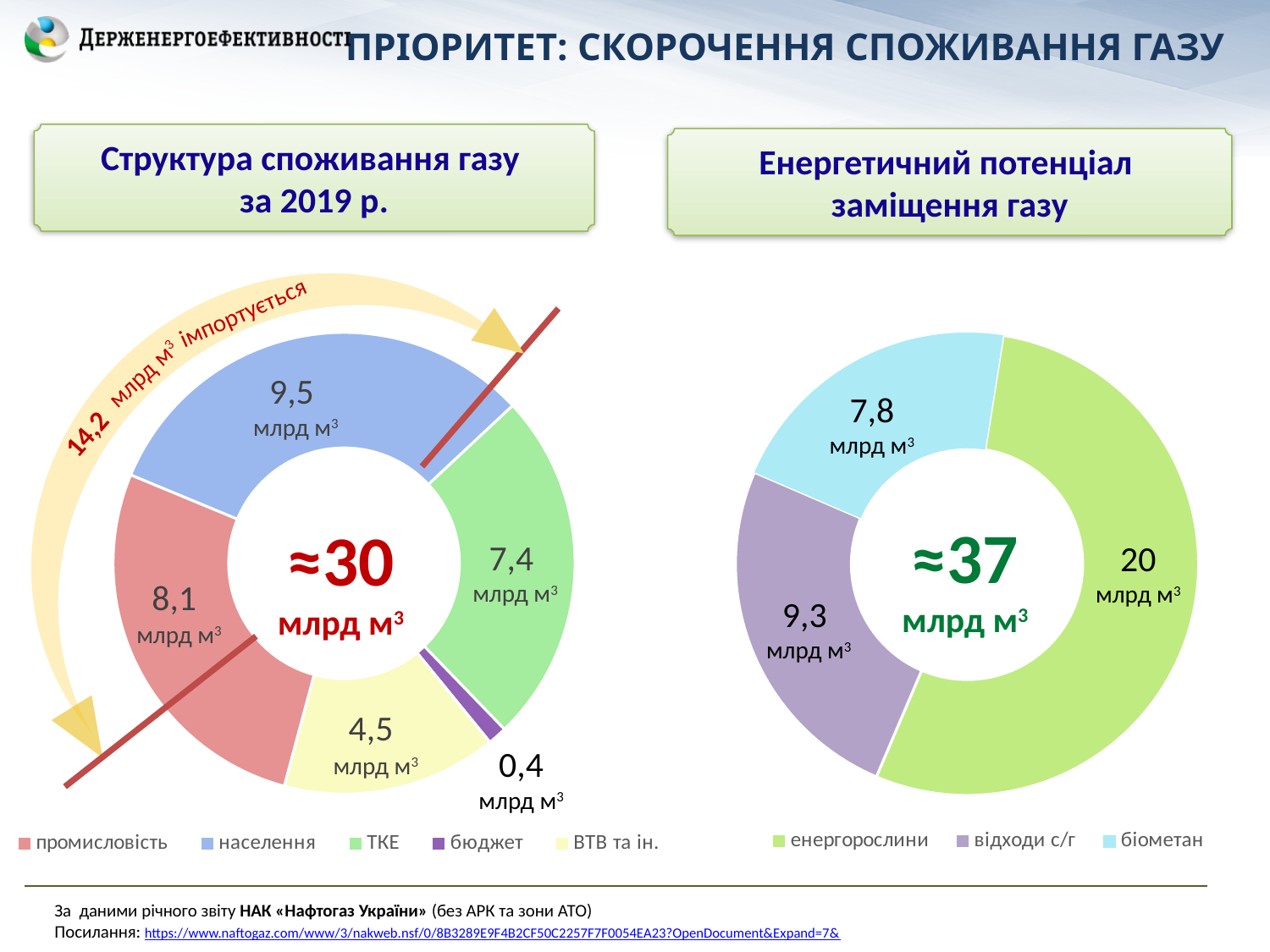
In the chart 'Енергетичний потенціал заміщення газу', which category has the highest value? енергорослини In the chart 'Енергетичний потенціал заміщення газу', which is larger: відходи с/г or біометан? відходи с/г In the chart 'Структура споживання газу за 2019 р.', which category has the highest value? населення In the chart 'Структура споживання газу за 2019 р.', what is the value for ТКЕ? 7,4 млрд м3 In the chart 'Структура споживання газу за 2019 р.', what is the value for населення? 9,5 млрд м3 In the chart 'Структура споживання газу за 2019 р.', which category has the lowest value? бюджет In the chart 'Структура споживання газу за 2019 р.', how many categories does the legend list? 5 In the chart 'Енергетичний потенціал заміщення газу', what is the difference between енергорослини and біометан? 12,2 млрд м3 In the chart 'Енергетичний потенціал заміщення газу', what is the value for відходи с/г? 9,3 млрд м3 What type of chart is 'Енергетичний потенціал заміщення газу'? doughnut chart In the chart 'Структура споживання газу за 2019 р.', what is the difference between промисловість and ВТВ та ін.? 3,6 млрд м3 In the chart 'Структура споживання газу за 2019 р.', what is the value for бюджет? 0,4 млрд м3